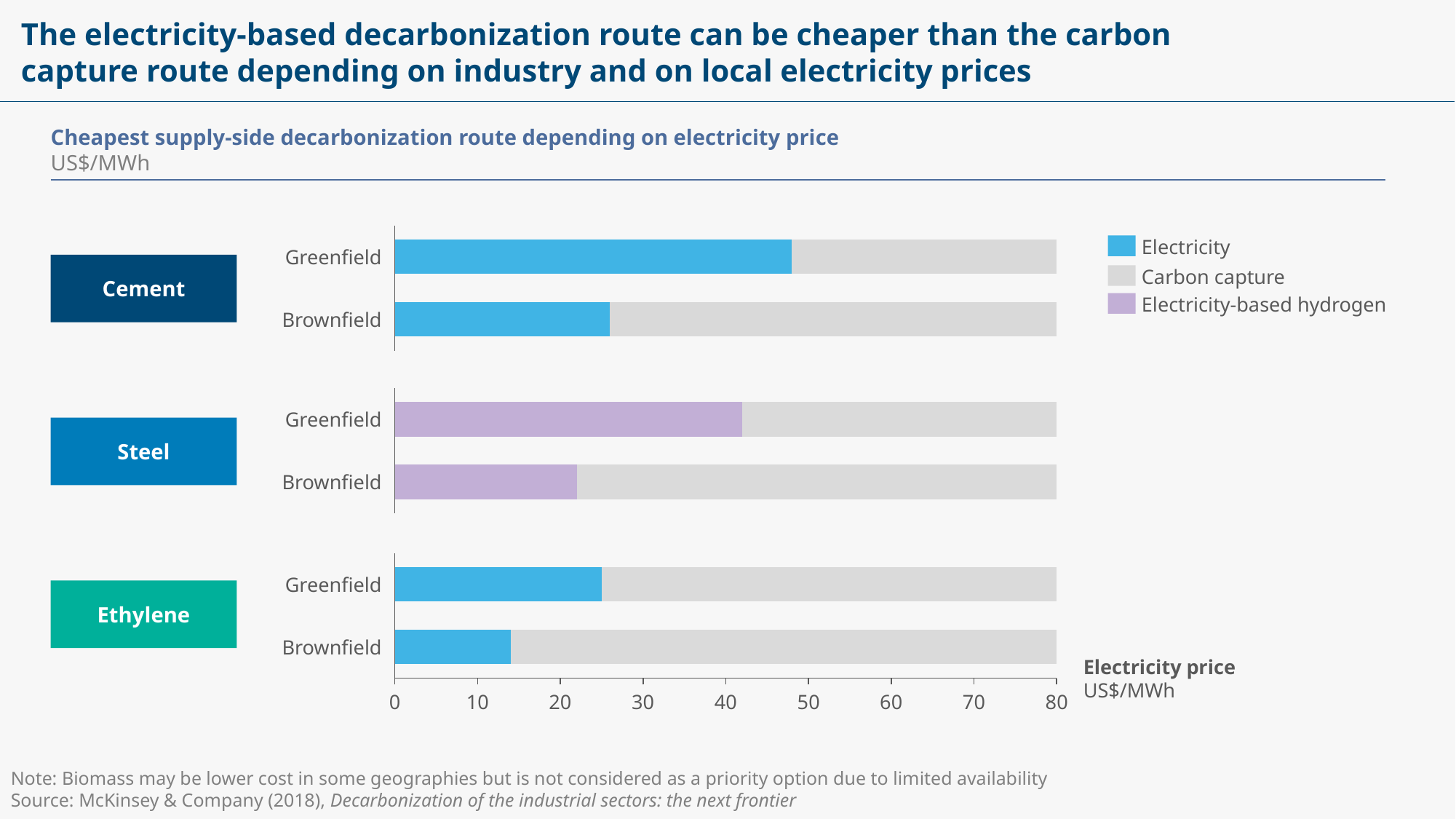
Which bar has the shortest coloured (non-carbon-capture) segment? Ethylene Brownfield How many series does the legend list? 3 Is the Electricity-based hydrogen segment for Steel Greenfield greater or less than 30 US$/MWh? greater Is the Electricity segment for Cement Brownfield greater or less than 30 US$/MWh? less Which is larger: the Electricity segment for Cement Greenfield or the Electricity-based hydrogen segment for Steel Greenfield? Cement Greenfield Is the Electricity segment for Cement Greenfield greater or less than 40 US$/MWh? greater What kind of chart is shown on the slide? Bar chart Which bar has the longest Electricity segment? Cement Greenfield Which is larger: the coloured segment for Steel Brownfield or for Ethylene Brownfield? Steel Brownfield Which industry's bars use the Electricity-based hydrogen series instead of Electricity? Steel How many bars are plotted in the chart? 6